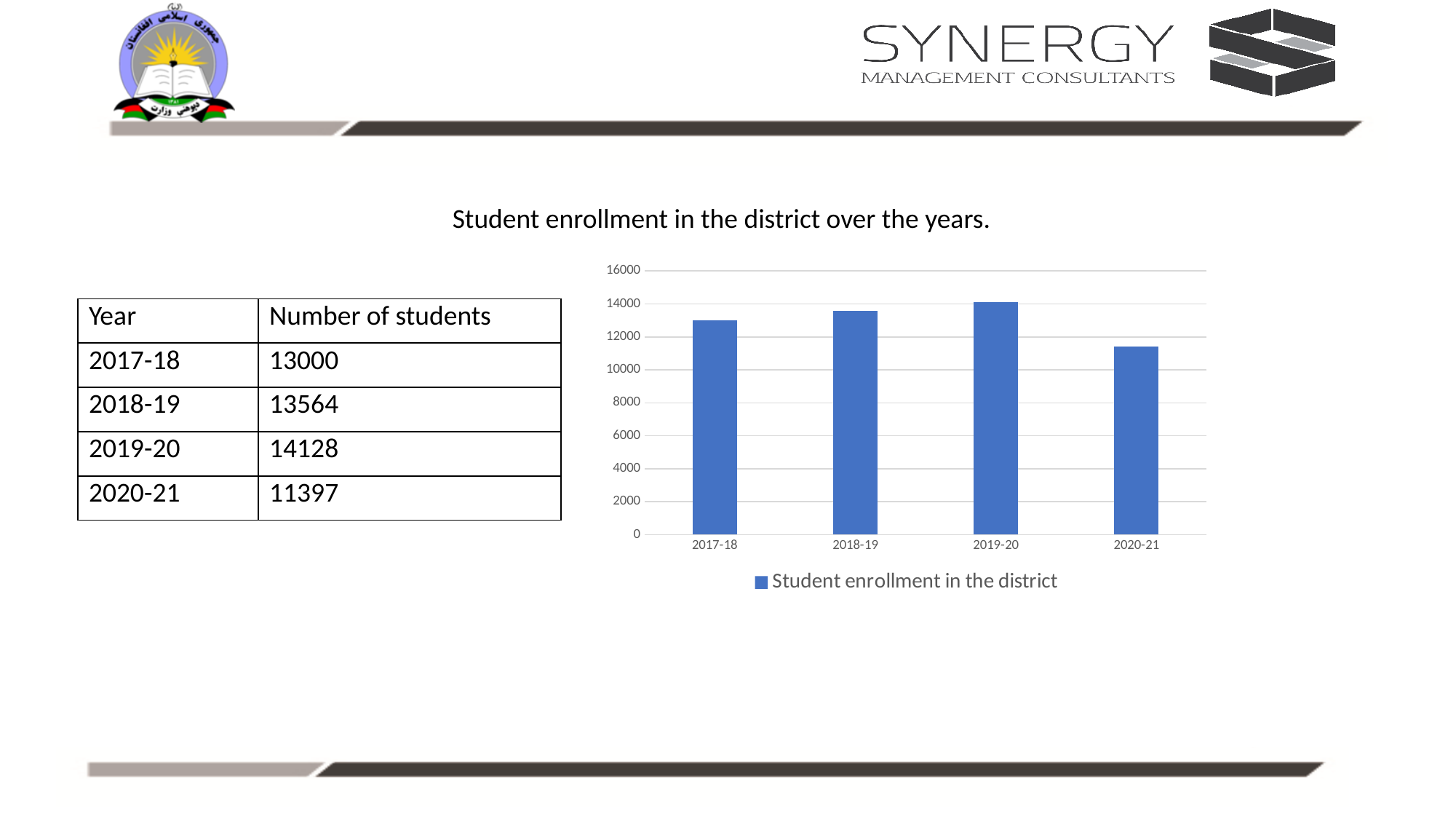
What is the legend entry for the series in the chart? Student enrollment in the district How many years are plotted on the chart? 4 Which year has the lowest student enrollment? 2020-21 What is the student enrollment for 2017-18? 13000 Which year has the highest student enrollment? 2019-20 How many series does the chart legend list? 1 Is the value for 2020-21 greater or less than 12000? less What is the student enrollment for 2020-21? 11397 Does student enrollment rise or fall from 2019-20 to 2020-21? fall What is the difference in student enrollment between 2019-20 and 2020-21? 2731 Which year has a larger student enrollment, 2018-19 or 2020-21? 2018-19 What kind of chart is shown on the slide? bar chart